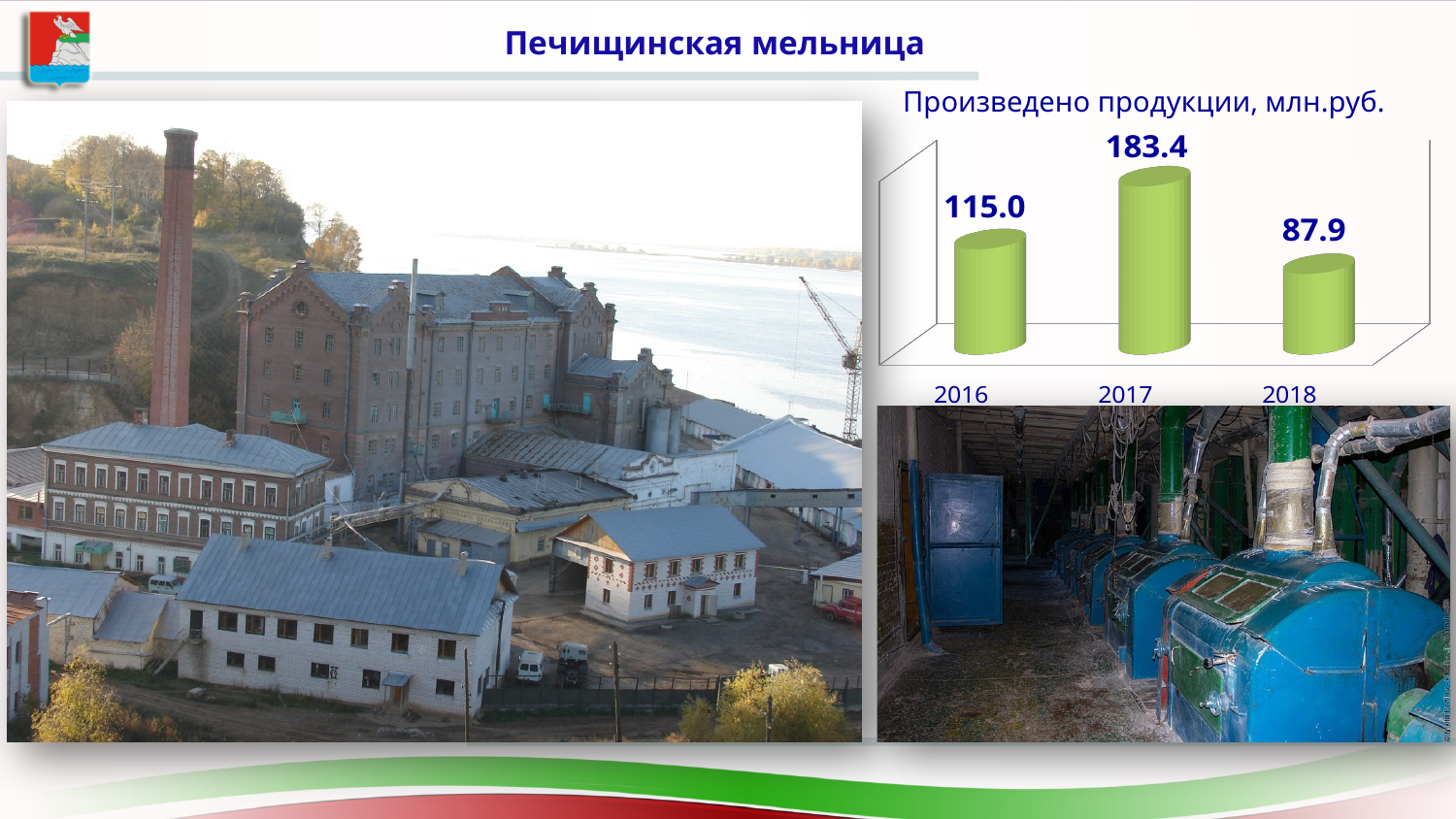
What was the value of products produced in 2018? 87.9 Which year had the lowest production value? 2018 What type of chart is shown on the slide? Bar chart Which year had a larger production value, 2016 or 2018? 2016 Which year had the highest production value? 2017 How many years are shown in the chart? 3 What is the difference between the production values for 2017 and 2016? 68.4 What was the value of products produced in 2017? 183.4 What is the title of the chart? Произведено продукции, млн.руб. What was the value of products produced in 2016? 115.0 What is the difference between the production values for 2016 and 2018? 27.1 Did the production value rise or fall from 2017 to 2018? Fall